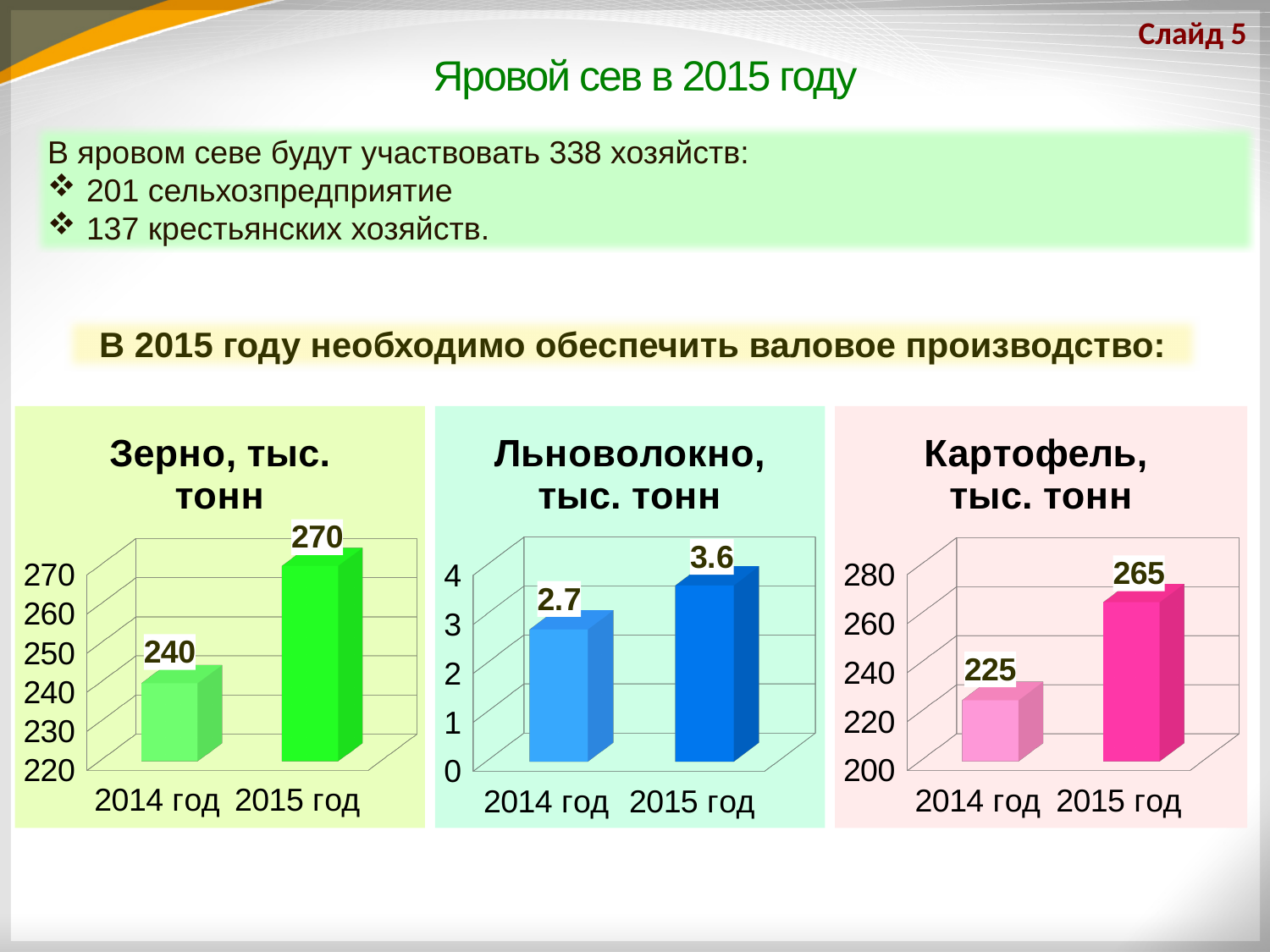
In the chart titled "Зерно, тыс. тонн", what is the difference between the 2015 год and 2014 год values? 30 In the chart titled "Картофель, тыс. тонн", which year has the lower value? 2014 год In the chart titled "Зерно, тыс. тонн", what is the value for 2014 год? 240 In the chart titled "Льноволокно, тыс. тонн", which year has the higher value? 2015 год In the chart titled "Картофель, тыс. тонн", what is the value for 2015 год? 265 How many categories are shown on the x axis of the chart titled "Льноволокно, тыс. тонн"? 2 In the chart titled "Зерно, тыс. тонн", what is the value for 2015 год? 270 In the chart titled "Льноволокно, тыс. тонн", what is the value for 2015 год? 3.6 In the chart titled "Картофель, тыс. тонн", what is the difference between the 2015 год and 2014 год values? 40 What kind of chart is the chart titled "Зерно, тыс. тонн"? Bar chart In the chart titled "Льноволокно, тыс. тонн", what is the value for 2014 год? 2.7 In the chart titled "Картофель, тыс. тонн", what is the value for 2014 год? 225